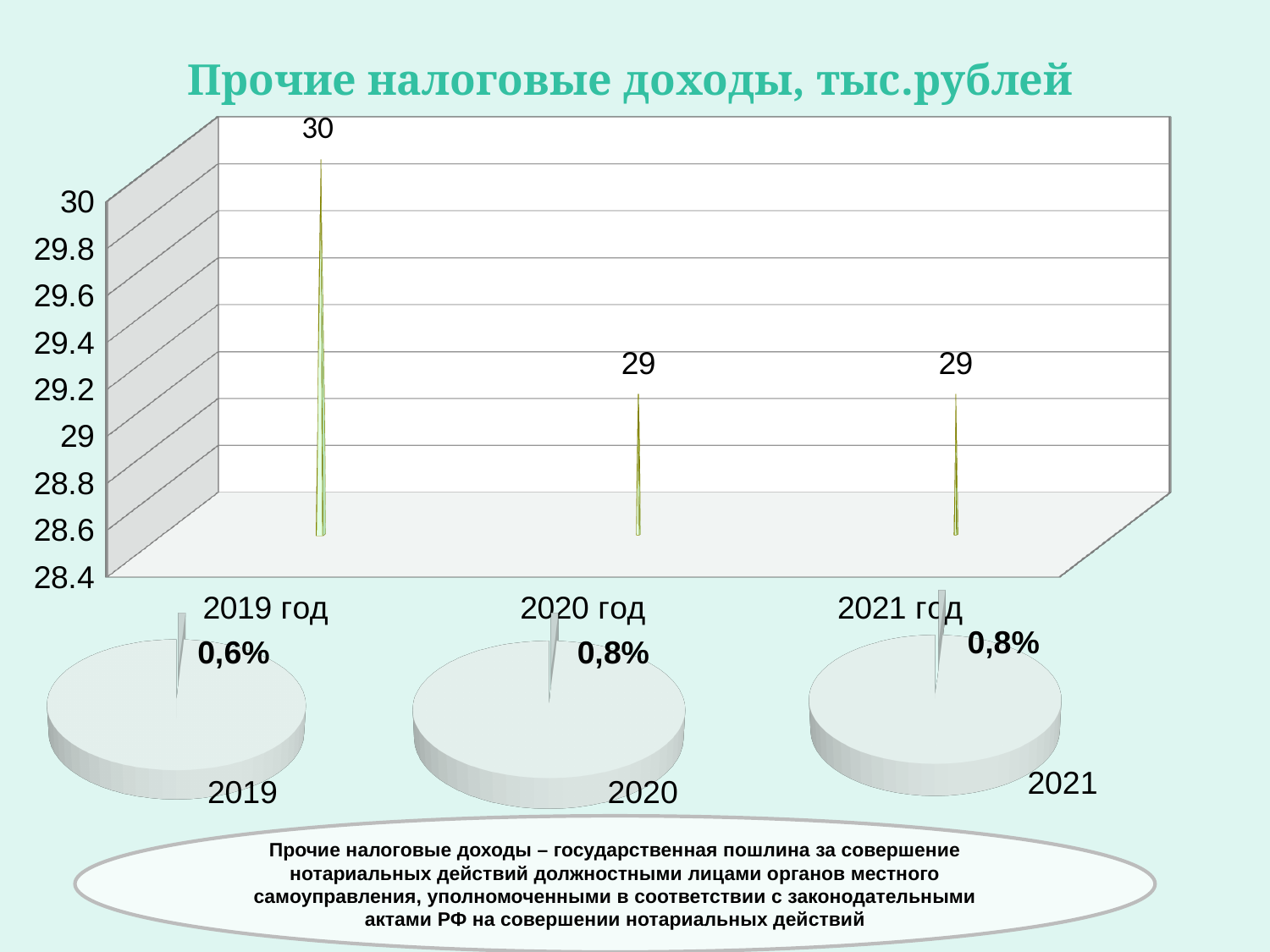
On the pie chart labelled 2019 at the bottom left, what share is shown for the small slice? 0,6% On the bar chart 'Прочие налоговые доходы, тыс.рублей', what is the value for 2020 год? 29 On the bar chart 'Прочие налоговые доходы, тыс.рублей', what is the value for 2019 год? 30 On the bar chart 'Прочие налоговые доходы, тыс.рублей', which is larger: the value for 2019 год or the value for 2021 год? 2019 год What kind of chart is the large chart at the top of the slide? Bar chart On the bar chart 'Прочие налоговые доходы, тыс.рублей', which year has the highest value? 2019 год On the bar chart 'Прочие налоговые доходы, тыс.рублей', do the values rise or fall from 2019 год to 2020 год? Fall What is the title of the bar chart at the top of the slide? Прочие налоговые доходы, тыс.рублей On the pie chart labelled 2020 at the bottom centre, what share is shown for the small slice? 0,8% On the bar chart 'Прочие налоговые доходы, тыс.рублей', what is the value for 2021 год? 29 On the bar chart 'Прочие налоговые доходы, тыс.рублей', how many years are shown on the x axis? 3 On the bar chart 'Прочие налоговые доходы, тыс.рублей', what is the difference between the values for 2019 год and 2020 год? 1